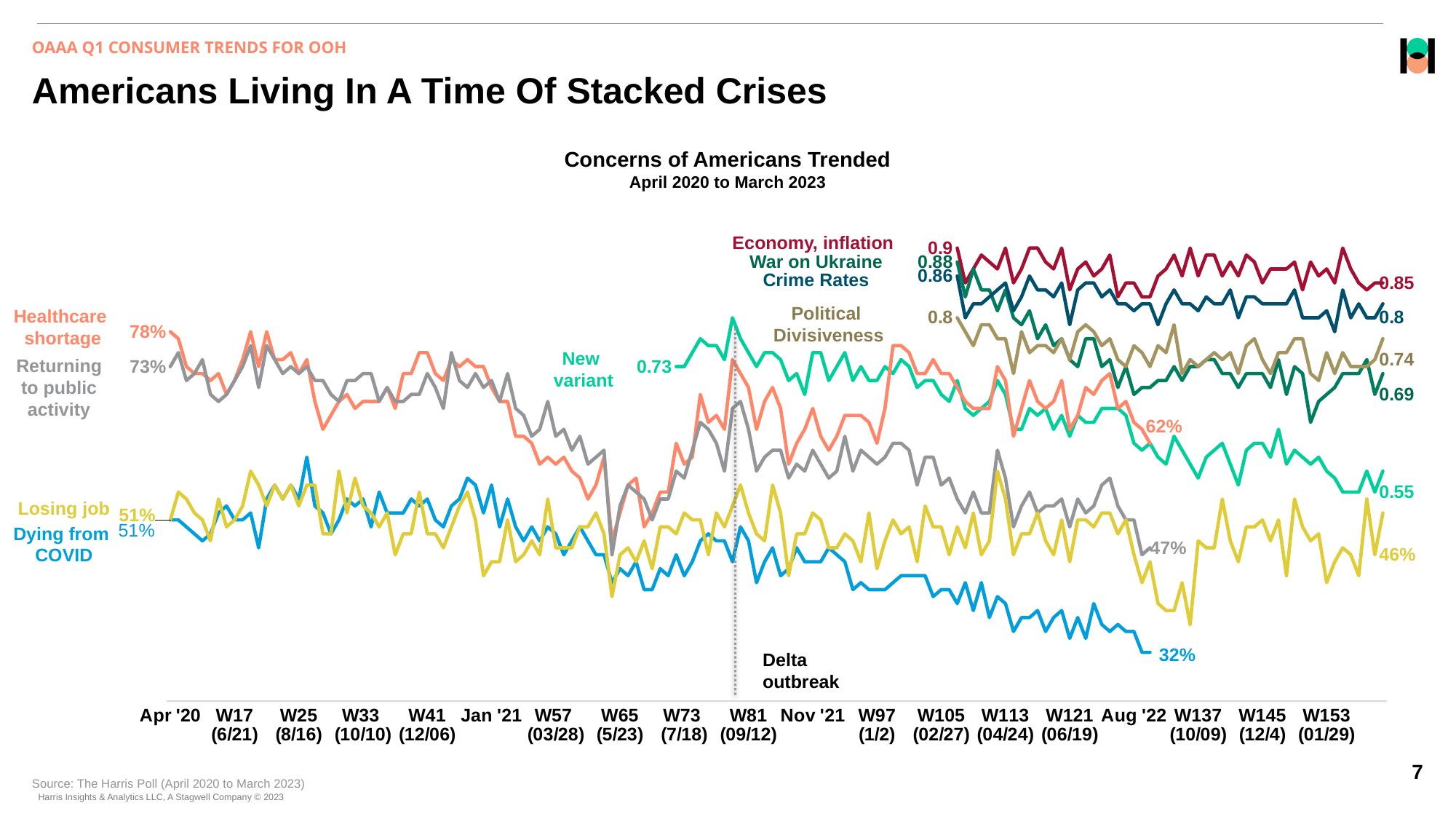
By how many percentage points did the Dying from COVID series fall from its labeled start (51%) to its labeled end (32%)? 19 percentage points Does the Dying from COVID series rise or fall over the period shown? fall What is the starting value shown for the New variant series? 0.73 What is the final value shown for the Dying from COVID series? 32% What is the starting value shown for the Healthcare shortage series in April 2020? 78% At the right end of the chart, which is higher: War on Ukraine or Political Divisiveness? Political Divisiveness What type of chart is shown on the slide? line chart Which series has the highest labeled value at the right end of the chart? Economy, inflation What is the final value shown for the Economy, inflation series? 0.85 What is the starting value shown for the Crime Rates series? 0.86 Which series has the lowest labeled final value on the chart? Dying from COVID By how many percentage points did the Healthcare shortage series fall from its labeled start (78%) to its labeled end (62%)? 16 percentage points